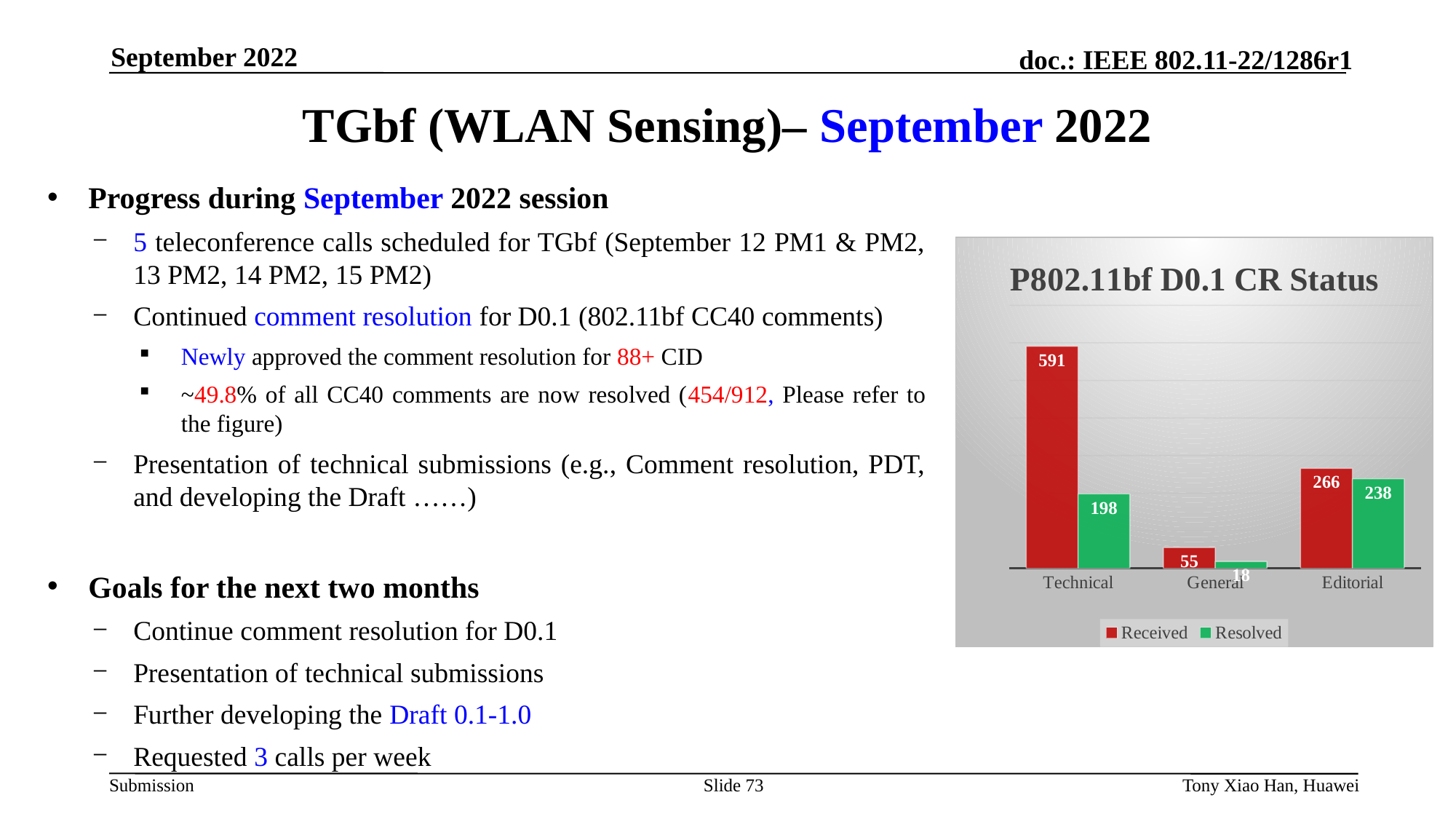
Is the Received value for General larger or smaller than the Resolved value for Technical in the P802.11bf D0.1 CR Status chart? smaller How many categories are shown on the x axis of the P802.11bf D0.1 CR Status chart? 3 What is the difference between Received and Resolved for Editorial in the P802.11bf D0.1 CR Status chart? 28 What is the difference between Received and Resolved for Technical in the P802.11bf D0.1 CR Status chart? 393 How many series does the legend of the P802.11bf D0.1 CR Status chart list? 2 Which category has the highest Received value in the P802.11bf D0.1 CR Status chart? Technical What is the Received value for Technical in the P802.11bf D0.1 CR Status chart? 591 What is the Resolved value for General in the P802.11bf D0.1 CR Status chart? 18 What is the Resolved value for Editorial in the P802.11bf D0.1 CR Status chart? 238 Which category has the lowest Resolved value in the P802.11bf D0.1 CR Status chart? General What type of chart is the P802.11bf D0.1 CR Status chart? bar chart What colour are the Resolved bars in the P802.11bf D0.1 CR Status chart? green